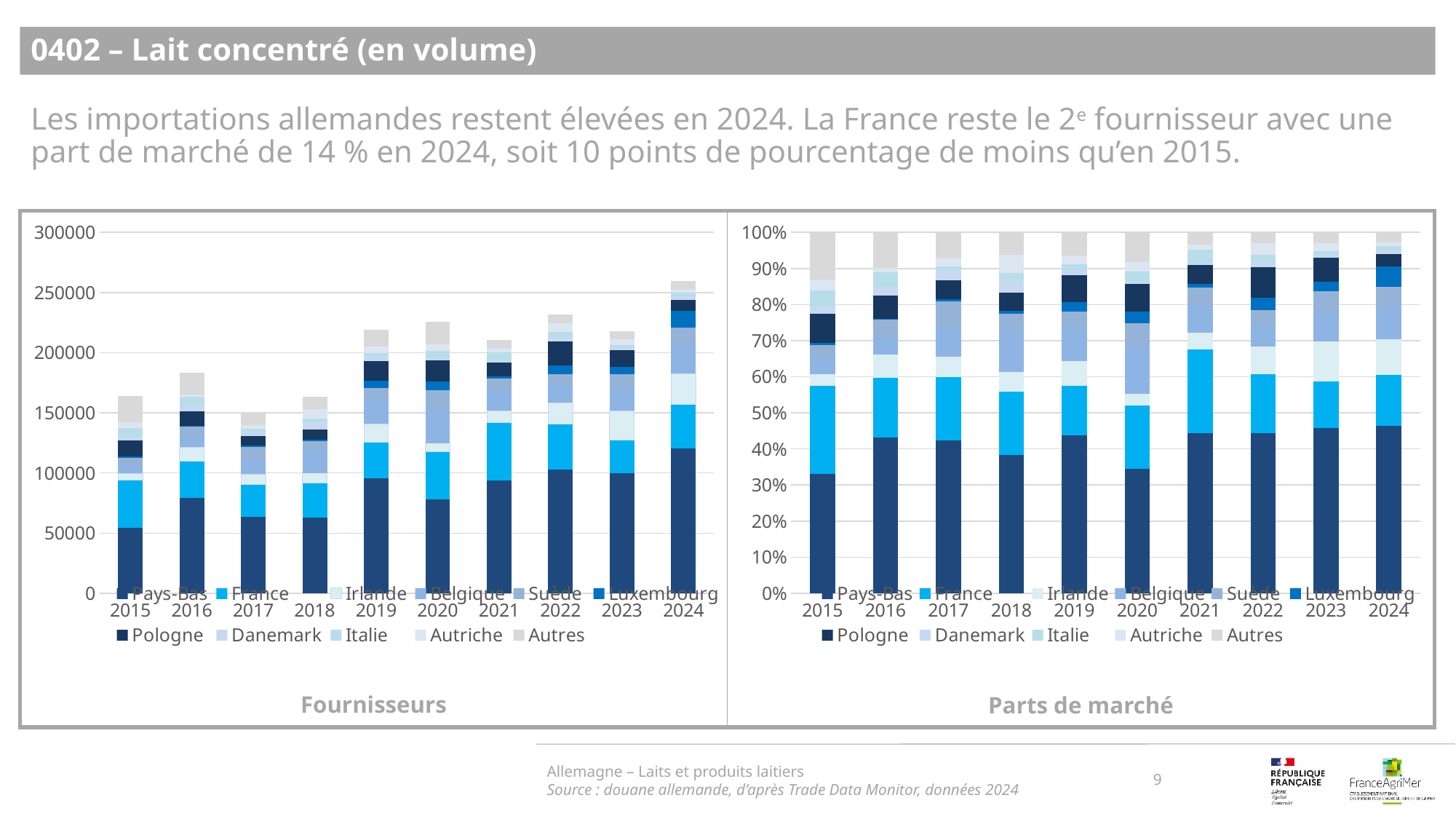
In the 'Fournisseurs' chart, which year has the lowest total bar? 2017 How many years are shown on the x axis of the 'Parts de marché' chart? 10 How many series does the legend of the 'Fournisseurs' chart list? 11 What is the title of the chart on the right of the slide? Parts de marché In the 'Parts de marché' chart, does the Pologne share rise or fall overall from 2015 to 2024? fall In the 'Parts de marché' chart, is the Pologne share for 2015 greater or less than 40%? less In the 'Fournisseurs' chart, which total bar is larger, 2015 or 2024? 2024 In the 'Parts de marché' chart, is the Pologne share for 2024 greater or less than 40%? less In the 'Fournisseurs' chart, is the total bar for 2024 greater or less than 250000? greater What kind of chart is the 'Fournisseurs' chart on the left? stacked bar chart In the 'Fournisseurs' chart, which year has the highest total bar? 2024